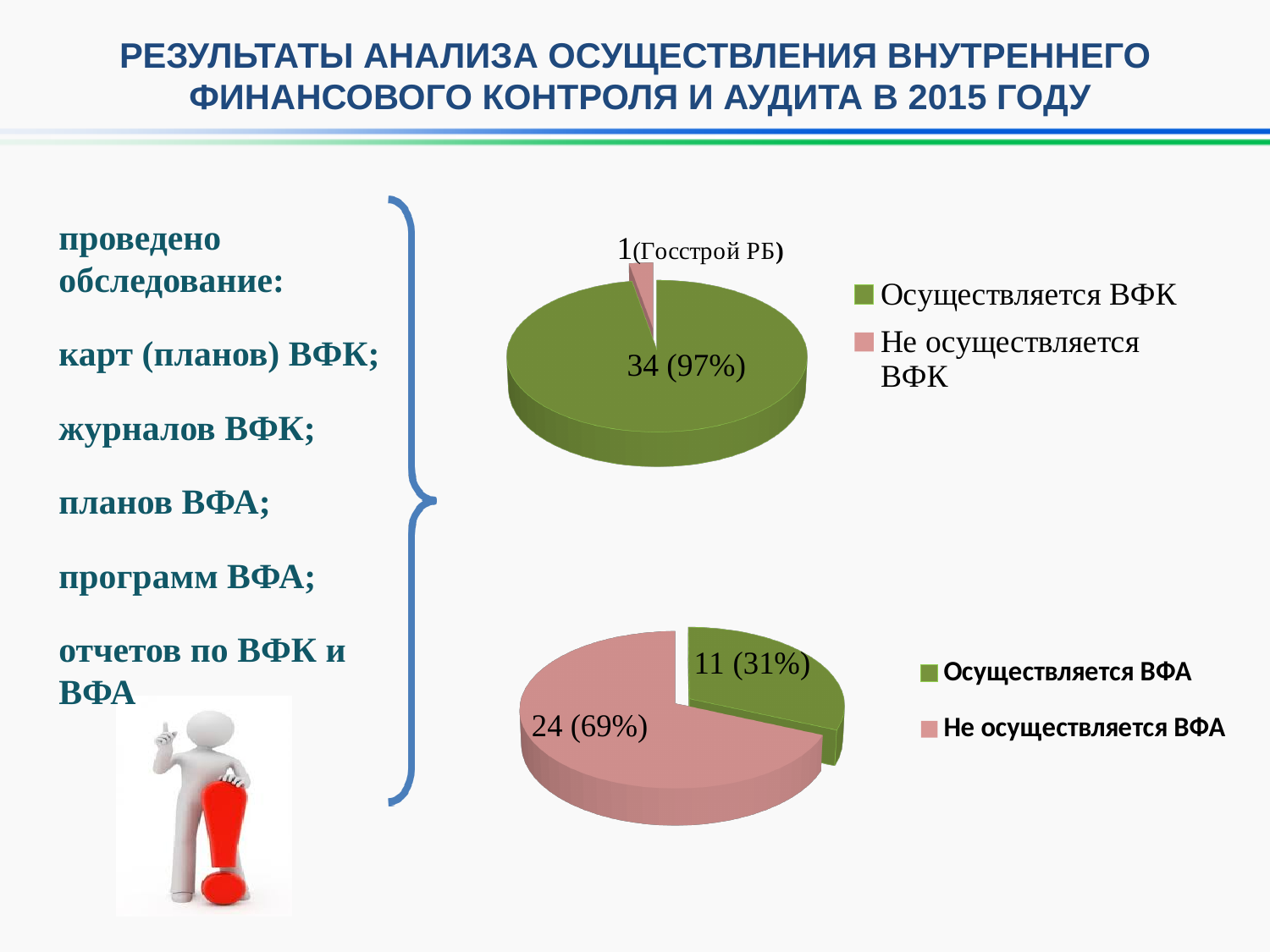
In the top pie chart, what value is shown for the slice "Осуществляется ВФК"? 34 (97%) In the bottom pie chart, what value is shown for the slice "Осуществляется ВФА"? 11 (31%) In the bottom pie chart, what colour is the slice for "Не осуществляется ВФА"? pink In the bottom pie chart, what share of the pie does the slice "Не осуществляется ВФА" represent? 69% In the bottom pie chart, what is the difference between the count for "Не осуществляется ВФА" and the count for "Осуществляется ВФА"? 13 In the bottom pie chart, which is larger: "Осуществляется ВФА" or "Не осуществляется ВФА"? Не осуществляется ВФА In the bottom pie chart, which slice is the smallest? Осуществляется ВФА In the top pie chart, what value is shown for the slice "Не осуществляется ВФК"? 1 (Госстрой РБ) In the bottom pie chart, what value is shown for the slice "Не осуществляется ВФА"? 24 (69%) In the top pie chart, which slice is the largest? Осуществляется ВФК What type of chart is the top chart on the slide? pie chart How many entries does the legend of the top pie chart list? 2